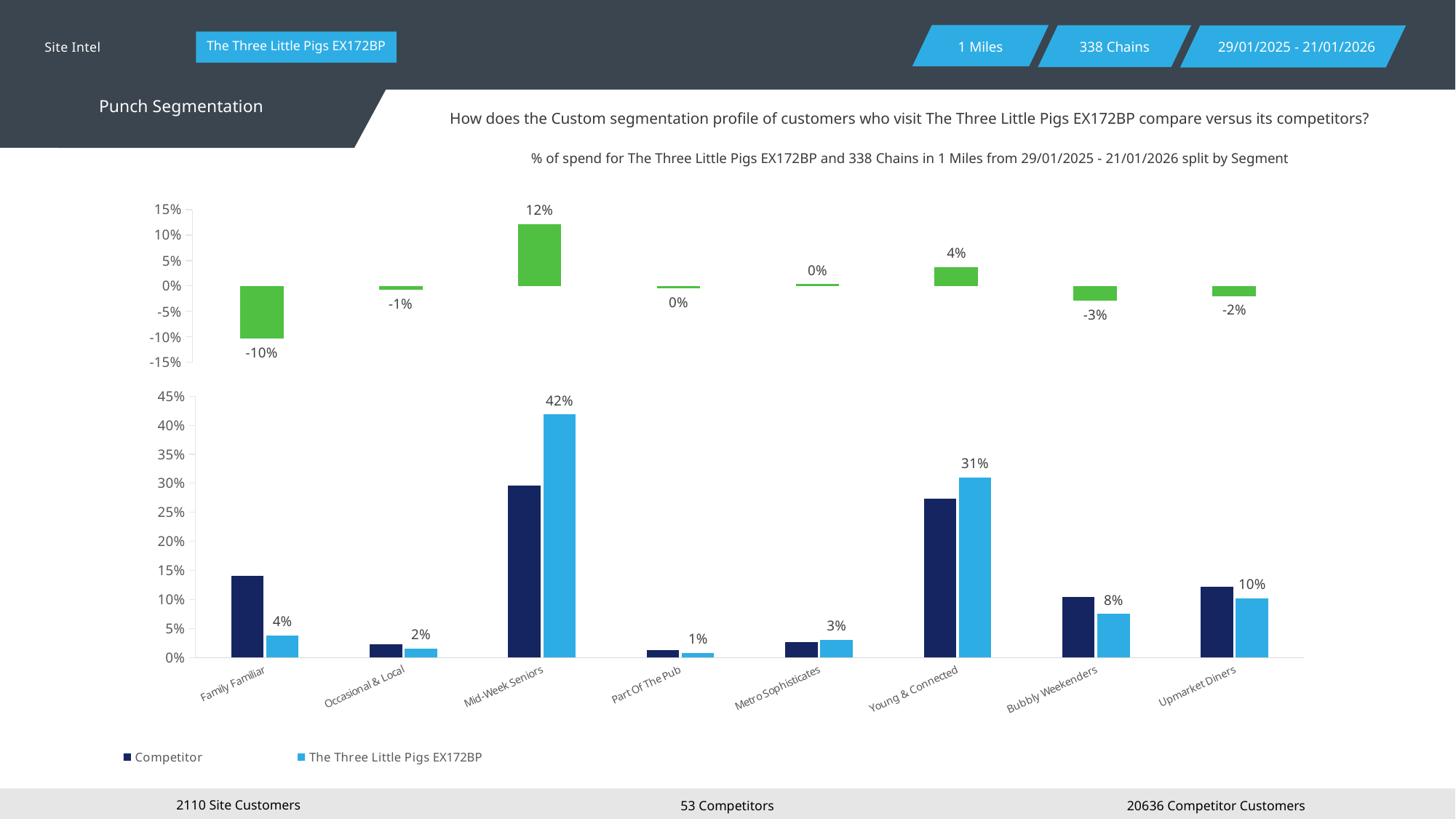
In the bottom chart, what is the value for The Three Little Pigs EX172BP for Young & Connected? 31% In the top chart, which segment has the lowest value? Family Familiar In the bottom chart, is the Competitor value for Family Familiar greater or less than 10%? greater In the bottom chart, for Family Familiar, which series has the larger value: Competitor or The Three Little Pigs EX172BP? Competitor What kind of chart is the bottom chart? bar chart How many segments are shown on the x axis of the bottom chart? 8 How many series does the legend of the bottom chart list? 2 In the top chart, what is the value for Family Familiar? -10% In the top chart, what is the value for Mid-Week Seniors? 12% In the bottom chart, what is the value for The Three Little Pigs EX172BP for Mid-Week Seniors? 42% In the top chart, which segment has the highest value? Mid-Week Seniors In the bottom chart, what is the difference between The Three Little Pigs EX172BP values for Mid-Week Seniors and Young & Connected? 11 percentage points